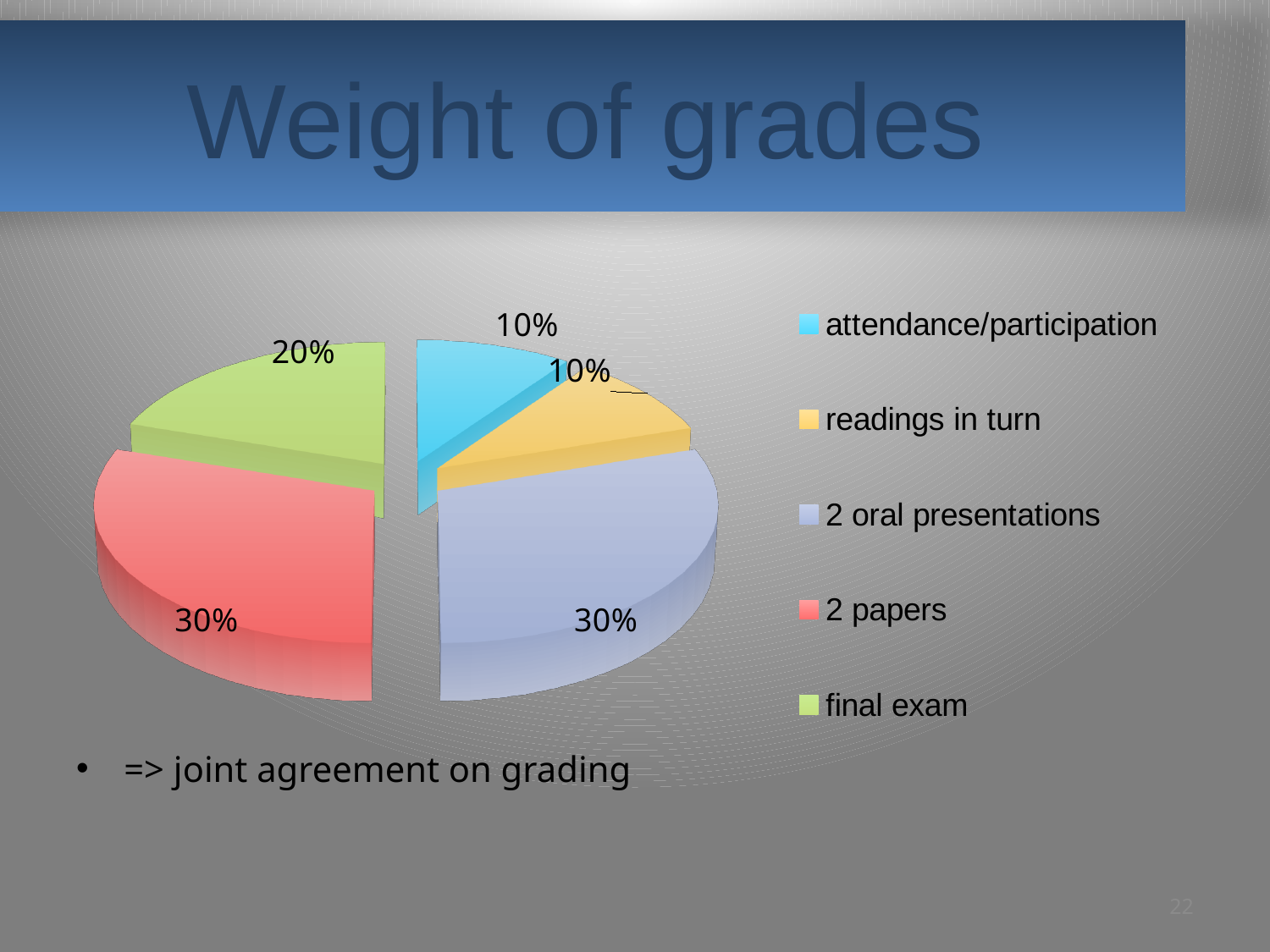
What percentage is shown for readings in turn? 10% What kind of chart is shown on the slide? pie chart Which colour represents the final exam slice in the pie chart? green What is the title of the slide containing the chart? Weight of grades How many entries does the legend list? 5 What percentage is shown for attendance/participation? 10% What percentage is shown for 2 oral presentations? 30% What share of the grade does the final exam account for? 20% How many slices does the pie chart have? 5 Which is larger, the share for final exam or the share for attendance/participation? final exam What percentage is shown for 2 papers? 30% What is the difference in percentage points between the 2 papers slice and the final exam slice? 10